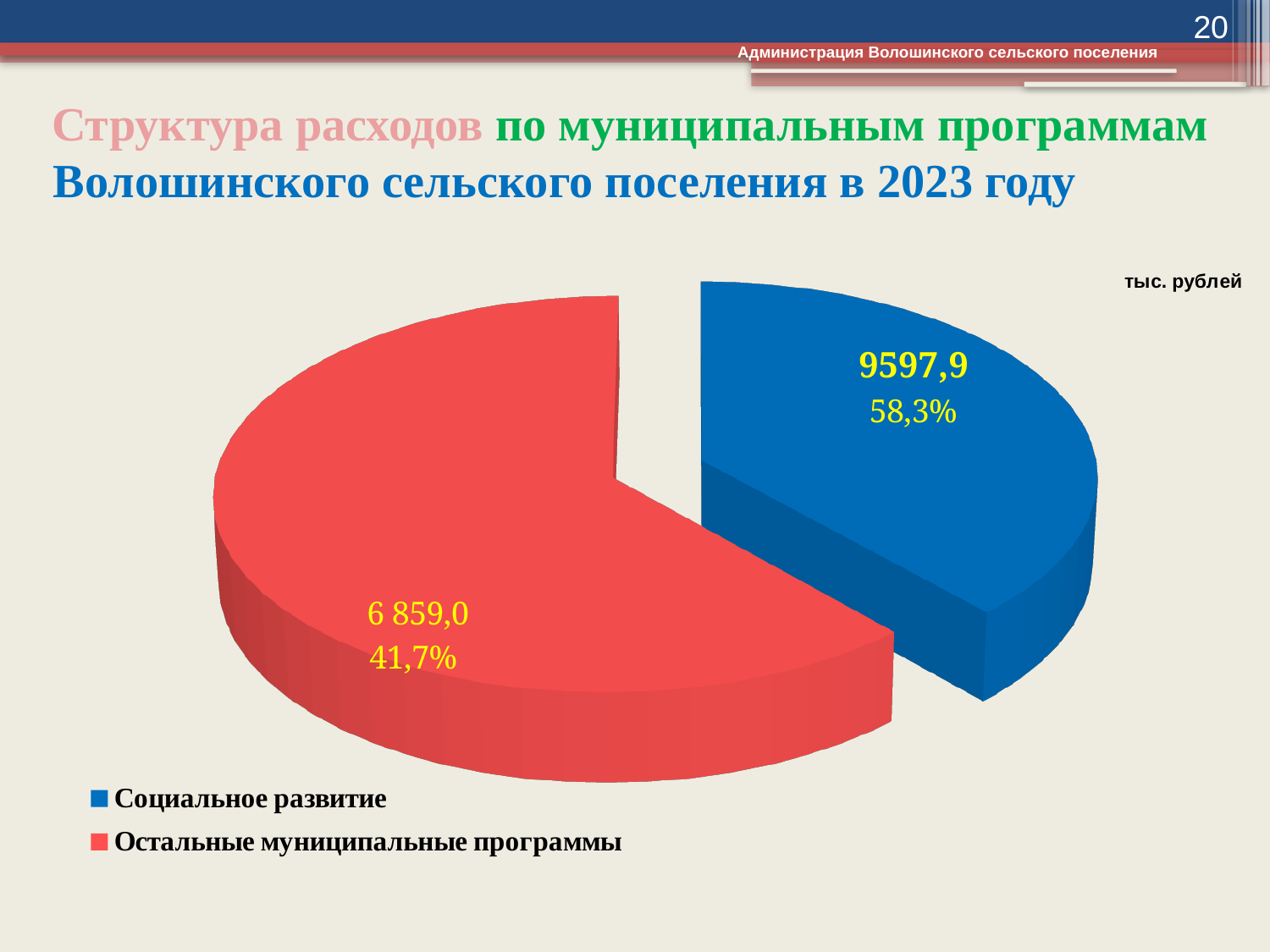
What unit is indicated for the values in the chart? тыс. рублей How many slices does the pie chart have? 2 How many entries does the legend list? 2 What is the difference between the values for Социальное развитие and Остальные муниципальные программы? 2738,9 What is the value for Социальное развитие? 9597,9 What is the value for Остальные муниципальные программы? 6 859,0 What share of the pie does Социальное развитие take? 58,3% What type of chart is shown on the slide? pie chart What share of the pie does Остальные муниципальные программы take? 41,7% Which is larger, Социальное развитие or Остальные муниципальные программы? Социальное развитие